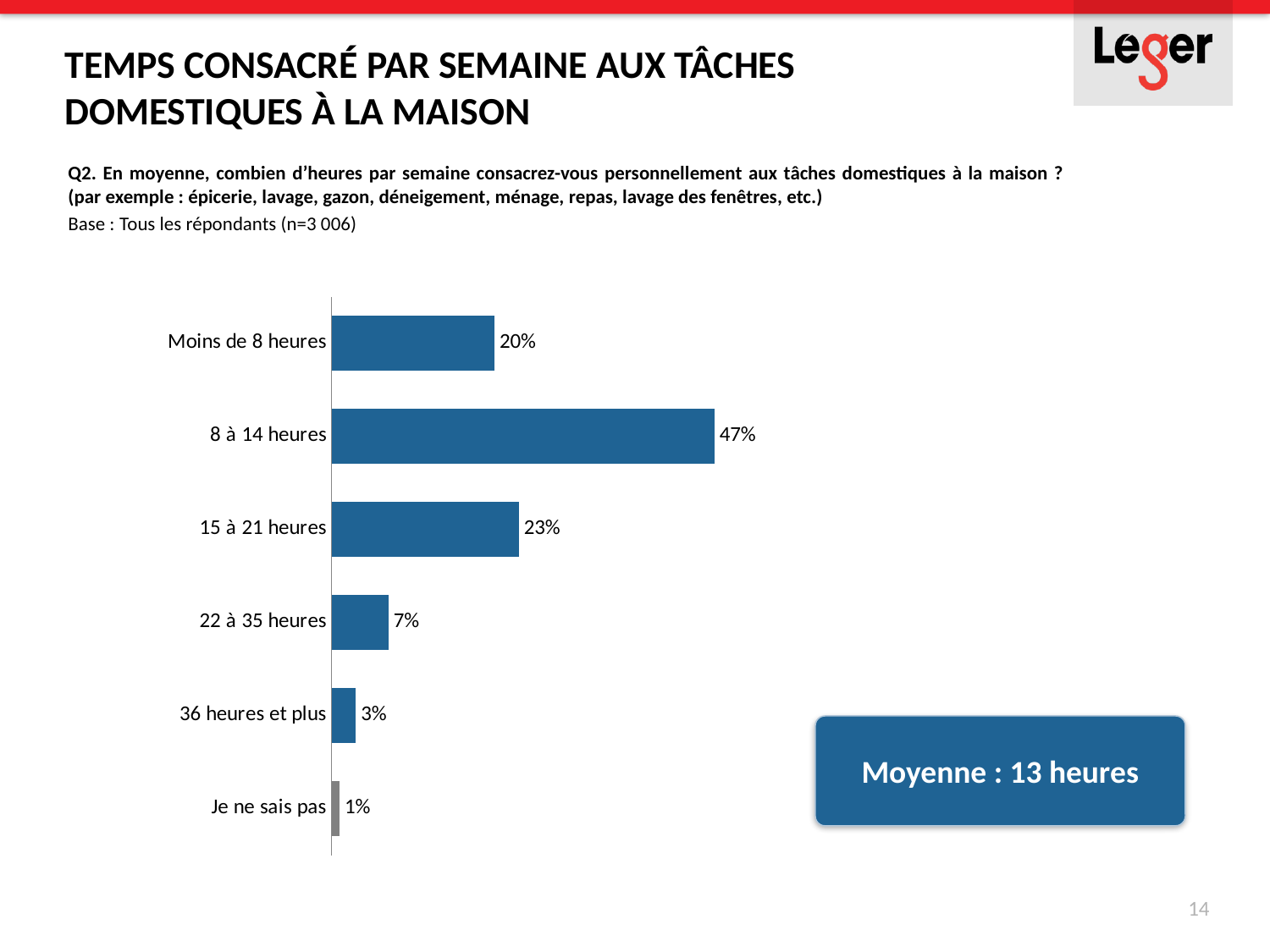
What is the value for 15 à 21 heures? 23% Which category has the highest value? 8 à 14 heures What is the average (Moyenne) number of hours shown in the box on the slide? 13 heures Which is larger, the value for Moins de 8 heures or the value for 22 à 35 heures? Moins de 8 heures Which category has the lowest value? Je ne sais pas What is the value for Moins de 8 heures? 20% What is the difference between the values for 22 à 35 heures and 36 heures et plus? 4% What is the value for 36 heures et plus? 3% What is the difference between the values for 8 à 14 heures and 15 à 21 heures? 24% How many categories are shown in the chart? 6 What percentage of respondents spend 8 à 14 heures per week on domestic tasks? 47% What kind of chart is shown on the slide? Bar chart